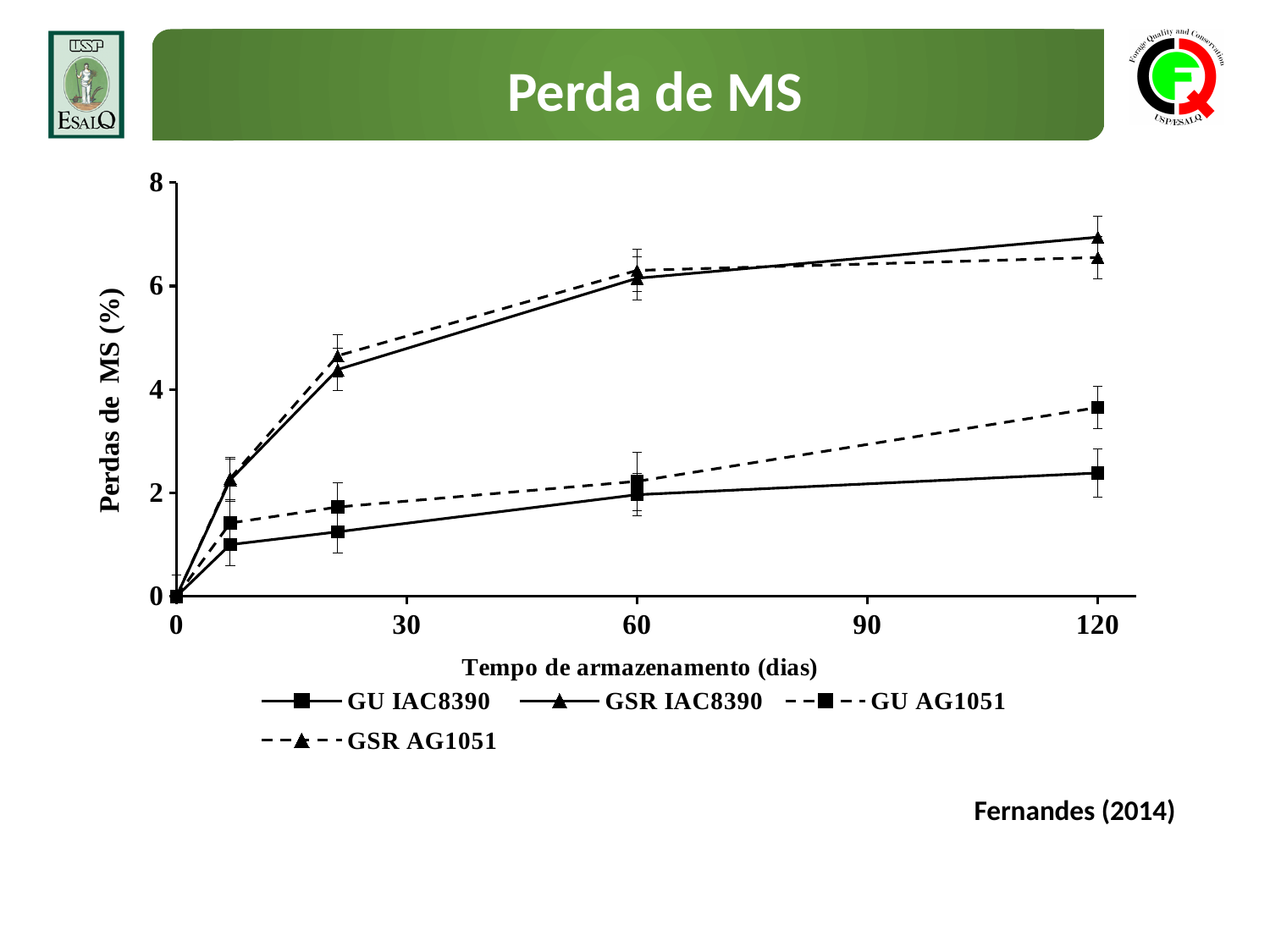
How many series does the legend list? 4 What is the label of the x axis? Tempo de armazenamento (dias) Do the values for GSR AG1051 rise or fall as storage time increases? rise How many data points are plotted for the GSR IAC8390 series? 5 Is the value for GU AG1051 at 120 days greater or less than 4? less Is the value for GU IAC8390 at 60 days greater or less than 4? less What kind of chart is shown on the slide? line chart Is the value for GSR IAC8390 at 120 days greater or less than 6? greater At 120 days, which is larger: GSR IAC8390 or GU IAC8390? GSR IAC8390 Which series has the lowest value at 120 days? GU IAC8390 What is the value for GU IAC8390 at 0 days? 0 What is the title of the chart? Perda de MS